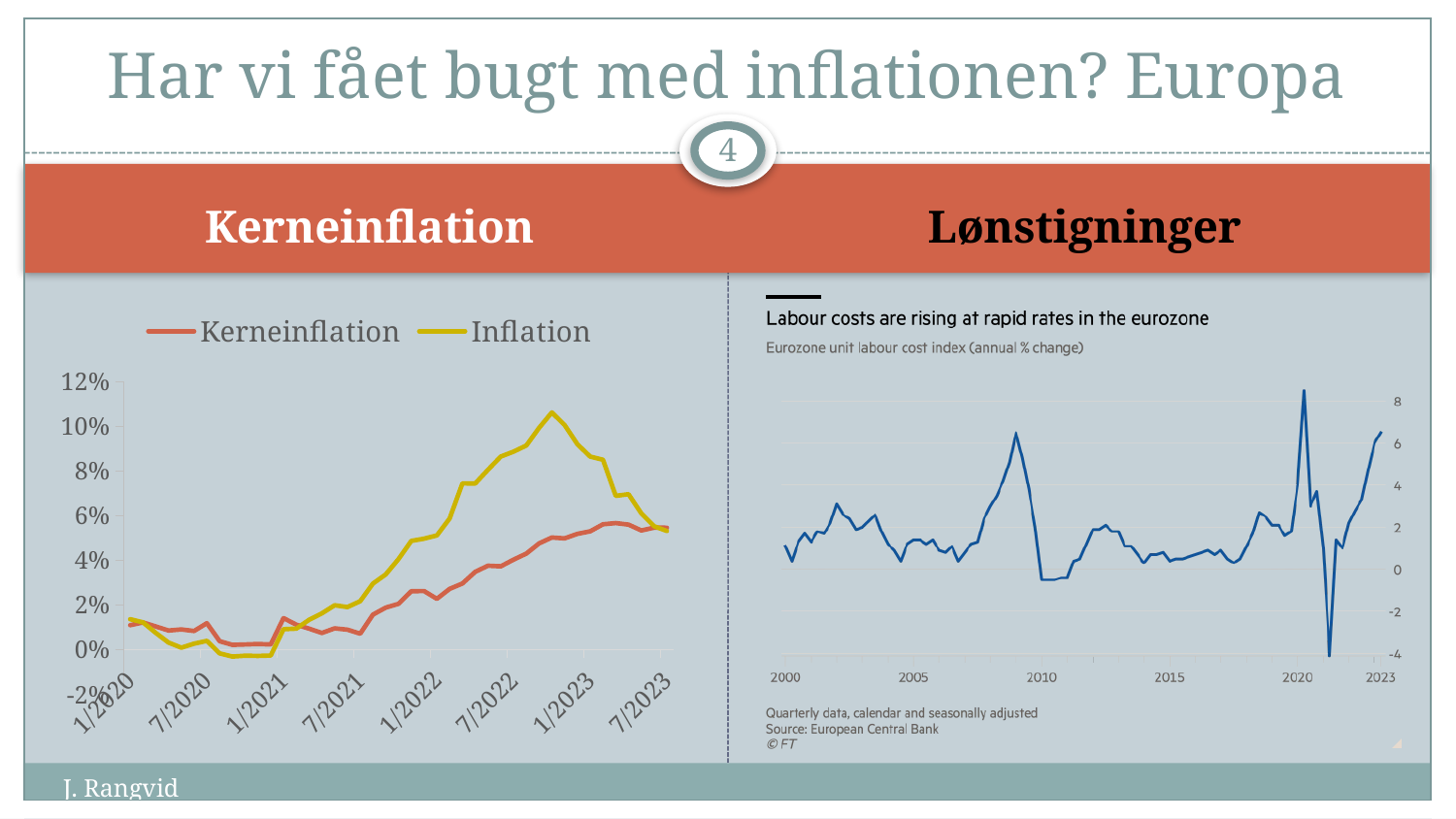
What is the source given for the right-hand Lønstigninger chart? European Central Bank What kind of chart is the Lønstigninger chart on the right of the slide? line chart In the left-hand Kerneinflation chart, does the Kerneinflation series rise or fall between 1/2021 and 1/2023? rise In the right-hand Lønstigninger chart, is the value at 2023 greater or less than 4? greater How many series does the legend of the left-hand Kerneinflation chart list? 2 In the left-hand Kerneinflation chart, which series is shown in yellow? Inflation In the left-hand Kerneinflation chart, is the value of Kerneinflation at 7/2023 greater or less than 4%? greater What kind of chart is the Kerneinflation chart on the left of the slide? line chart In the right-hand Lønstigninger chart, is the value around 2010 greater or less than 2? less In the left-hand Kerneinflation chart, which series is higher at 7/2022, Kerneinflation or Inflation? Inflation